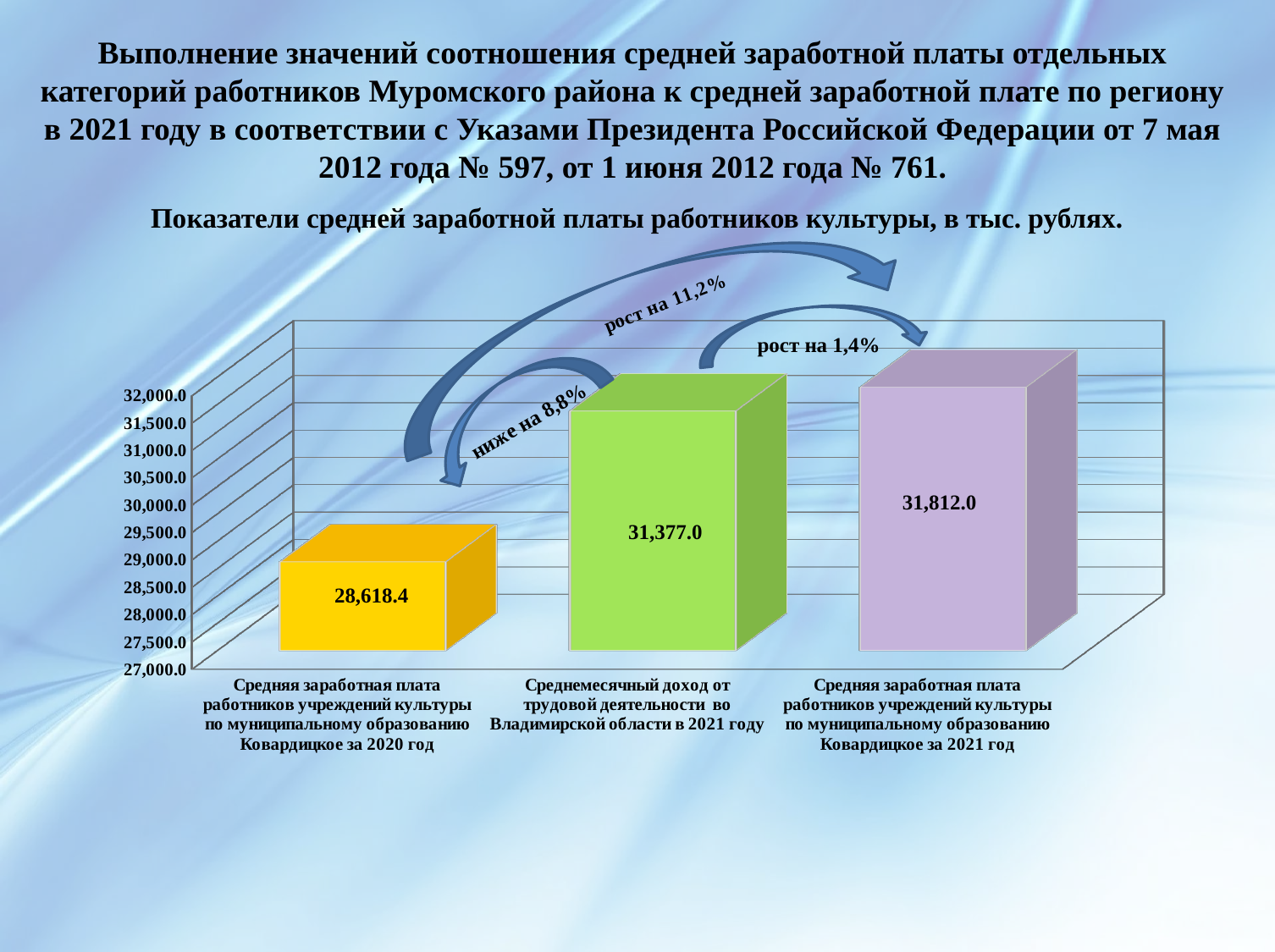
What is the difference between the 2021 Kovardickoe cultural workers' salary and the 2020 Kovardickoe cultural workers' salary? 3,193.6 What is the average salary of cultural institution workers in Kovardickoe municipality for 2021 (Средняя заработная плата работников учреждений культуры по муниципальному образованию Ковардицкое за 2021 год)? 31,812.0 What is the difference between the 2021 Kovardickoe cultural workers' salary and the Vladimir region average monthly income in 2021? 435.0 What is the average monthly labour income in Vladimir region in 2021 (Среднемесячный доход от трудовой деятельности во Владимирской области в 2021 году)? 31,377.0 Which category has the highest value on the chart? Средняя заработная плата работников учреждений культуры по муниципальному образованию Ковардицкое за 2021 год What is the average salary of cultural institution workers in Kovardickoe municipality for 2020 (Средняя заработная плата работников учреждений культуры по муниципальному образованию Ковардицкое за 2020 год)? 28,618.4 How many bars are shown on the chart? 3 What type of chart is shown on the slide? bar chart What percentage growth is annotated by the arrow from the 2020 Kovardickoe salary to the 2021 Kovardickoe salary? рост на 11,2% Which category has the lowest value on the chart? Средняя заработная плата работников учреждений культуры по муниципальному образованию Ковардицкое за 2020 год Is the value for the 2020 Kovardickoe cultural workers' salary greater or less than 29,000.0? less Which is larger: the Vladimir region average monthly income in 2021 or the Kovardickoe cultural workers' salary for 2020? Среднемесячный доход от трудовой деятельности во Владимирской области в 2021 году